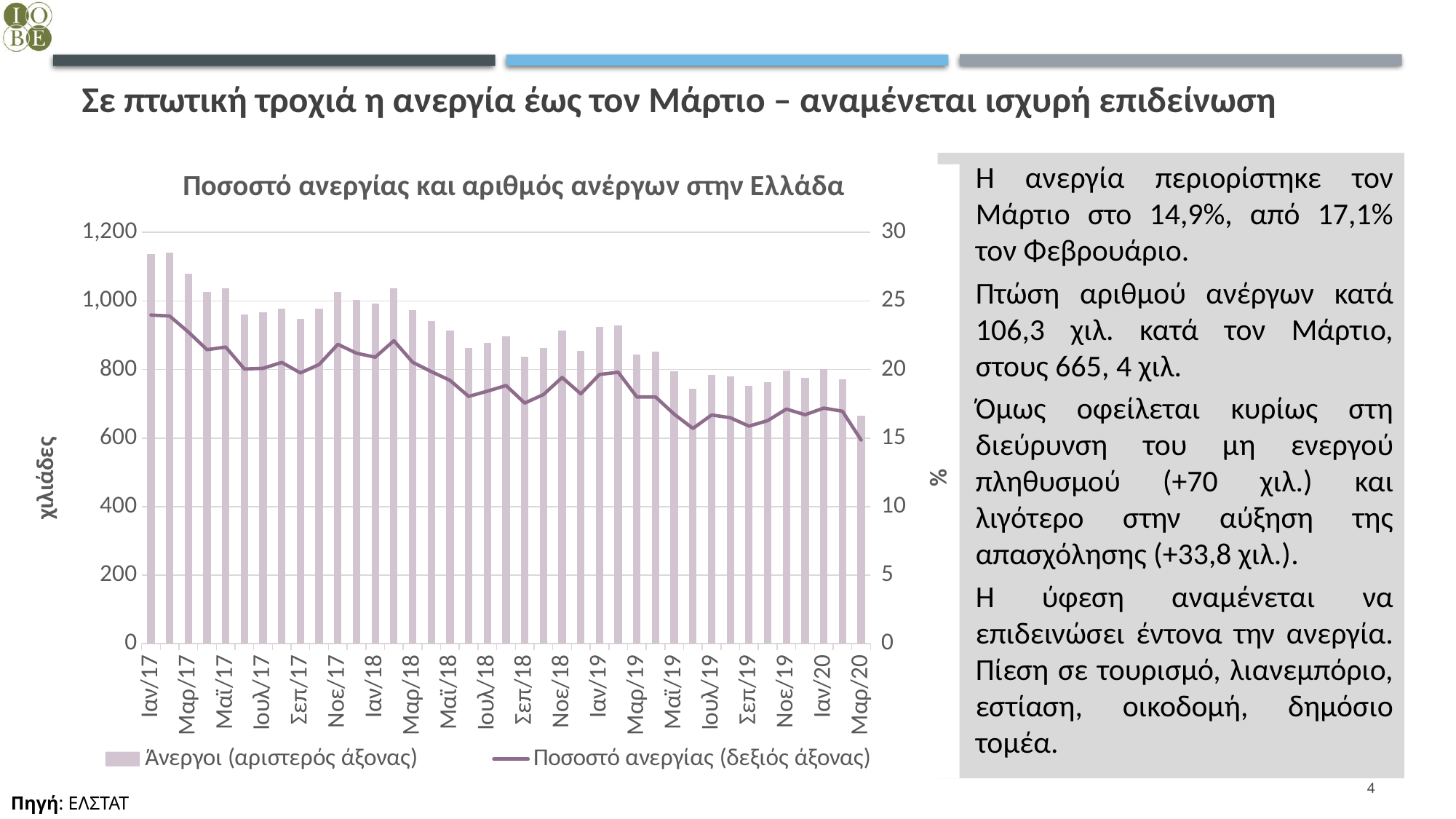
Is the unemployment rate (line) for Μαρ/20 greater or less than 20%? less Is the number of unemployed (bar) for Ιαν/17 greater or less than 1,000 thousand? greater Is the unemployment rate (line) for Ιαν/17 greater or less than 20%? greater What kind of chart is shown on the slide? Combined bar and line chart Which series is plotted as bars according to the legend? Άνεργοι (αριστερός άξονας) Does the unemployment rate line generally rise or fall from Ιαν/17 to Μαρ/20? fall Which is larger, the number of unemployed in Ιαν/18 or in Ιαν/20? Ιαν/18 How many series does the chart legend list? 2 What is the title of the chart? Ποσοστό ανεργίας και αριθμός ανέργων στην Ελλάδα Which month has the lowest unemployment rate (line) in the chart? Μαρ/20 Which month has the lowest number of unemployed (bar) in the chart? Μαρ/20